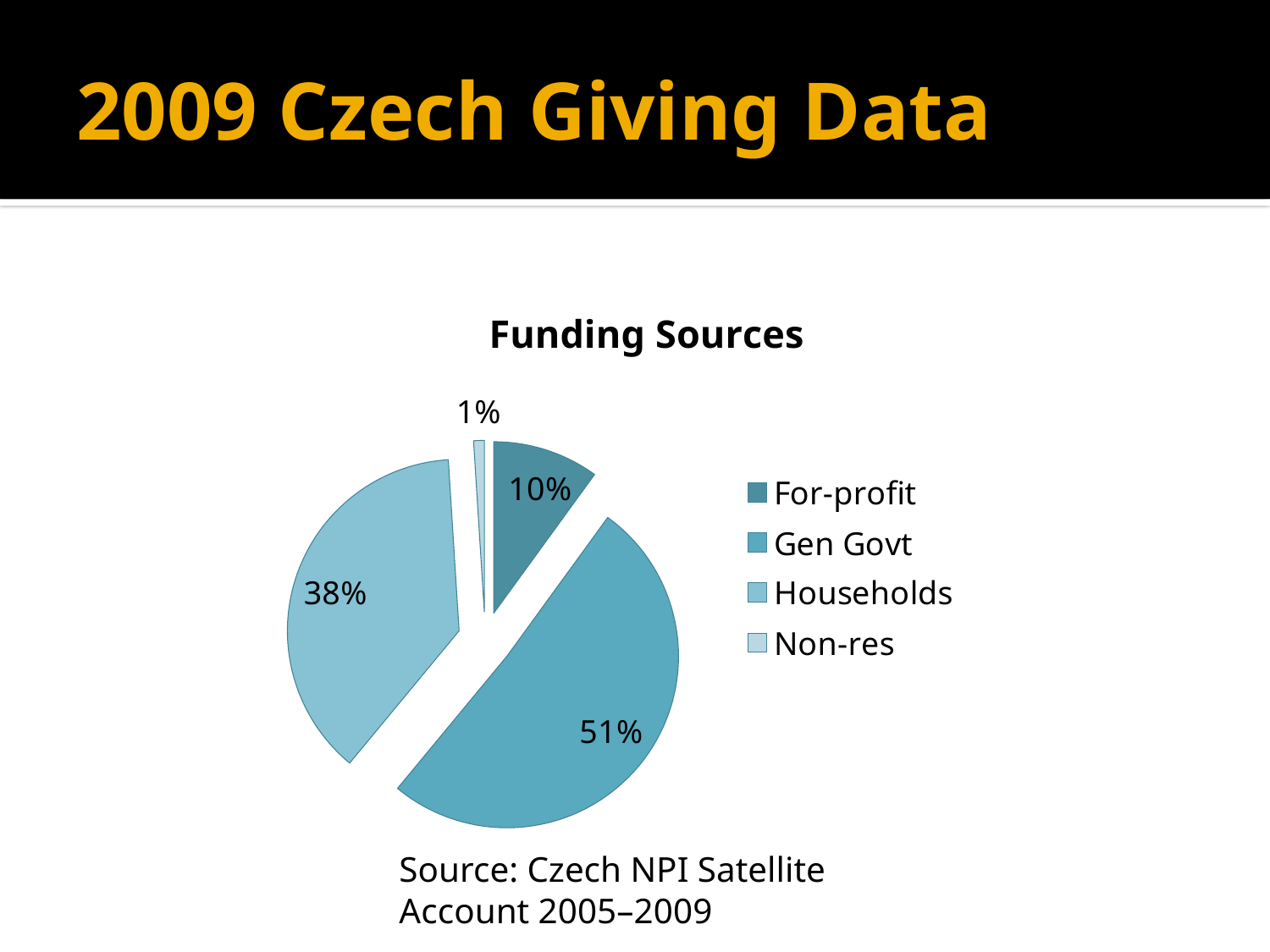
Which funding source has the smallest share? Non-res How many funding source categories are shown in the pie chart? 4 What is the title of the chart? Funding Sources Which funding source has the largest share? Gen Govt What share of funding sources comes from Gen Govt? 51% Which is larger, the Households share or the For-profit share? Households What share of funding sources comes from For-profit? 10% What is the difference in percentage points between the Gen Govt share and the Households share? 13 percentage points What share of funding sources comes from Households? 38% What source is cited below the chart? Czech NPI Satellite Account 2005–2009 What type of chart is shown on the slide? Pie chart